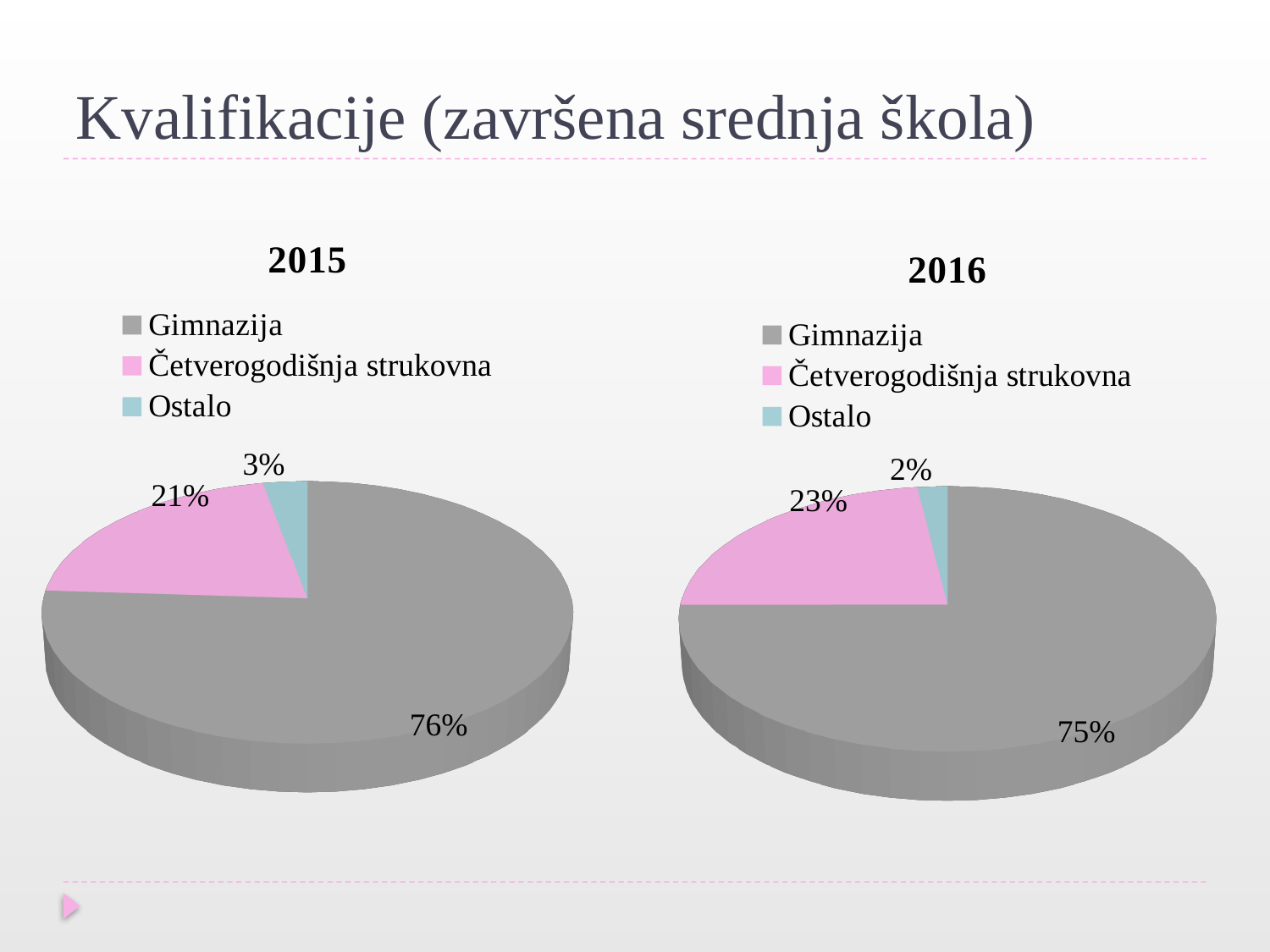
In the 2016 chart, which category has the largest slice? Gimnazija In the 2015 chart, what is the difference between the Gimnazija and Četverogodišnja strukovna shares? 55% In the 2016 chart, what share does Ostalo have? 2% How many slices does the 2016 chart have? 3 In the 2015 chart, what share does Ostalo have? 3% Is the Četverogodišnja strukovna share larger in the 2015 chart or the 2016 chart? 2016 How many entries does the legend of the 2015 chart list? 3 What kind of chart is the 2015 chart? Pie chart In the 2015 chart, which category has the smallest slice? Ostalo In the 2015 chart, what share does Gimnazija have? 76% In the 2016 chart, which colour represents Ostalo? Light blue In the 2016 chart, what share does Četverogodišnja strukovna have? 23%